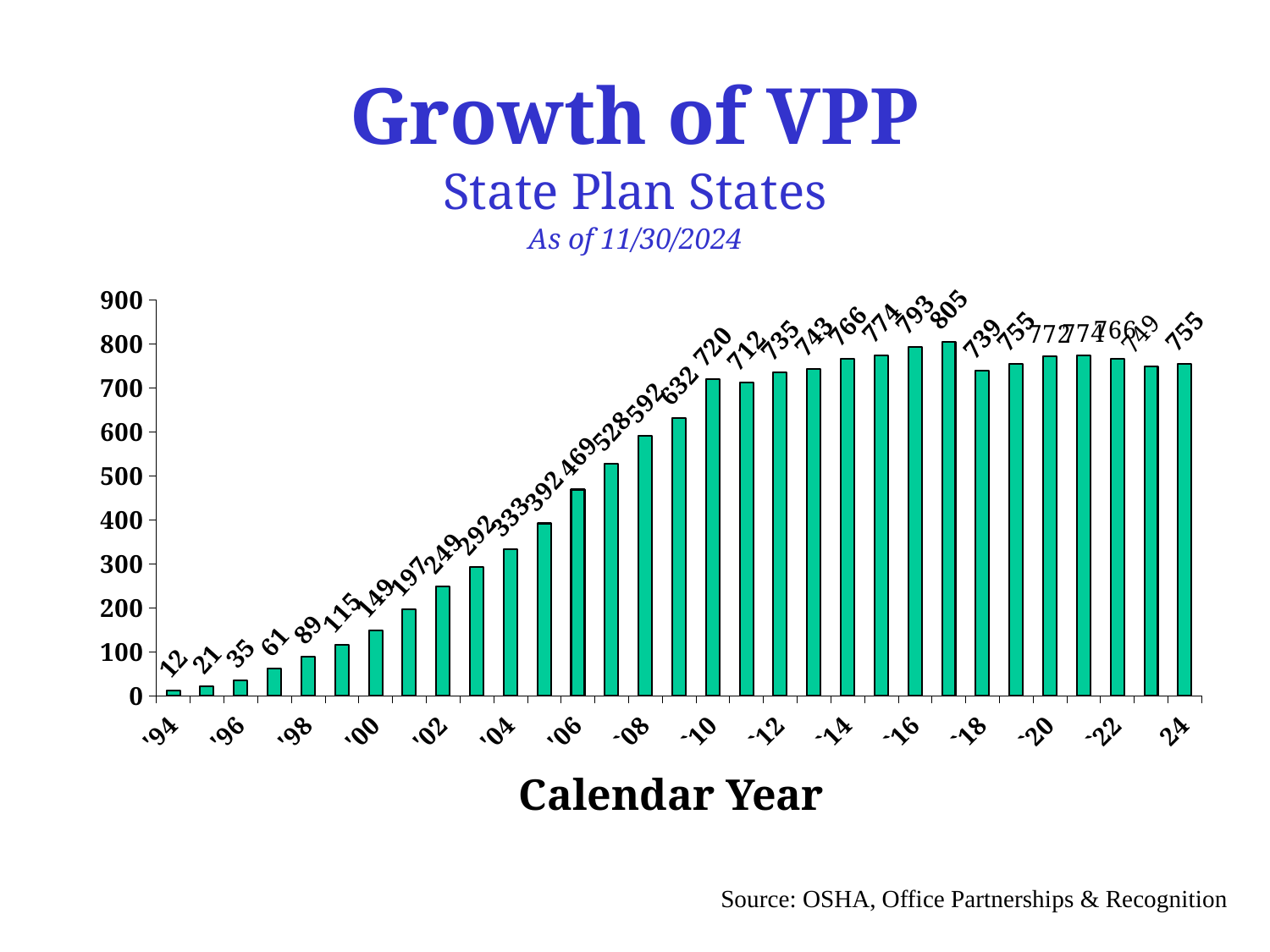
What type of chart is shown on the slide? bar chart Which is larger, the value for '10 or the value for '11? '10 What is the difference between the values for '17 and '18? 66 Which calendar year has the lowest value in the chart? '94 What is the value for '17? 805 What is the value for '10? 720 Do the values rise or fall from '94 to '17? rise What is the value for '94? 12 What is the value for '24? 755 Which calendar year has the highest value in the chart? '17 What is the title of the x axis? Calendar Year What is the value for '00? 149